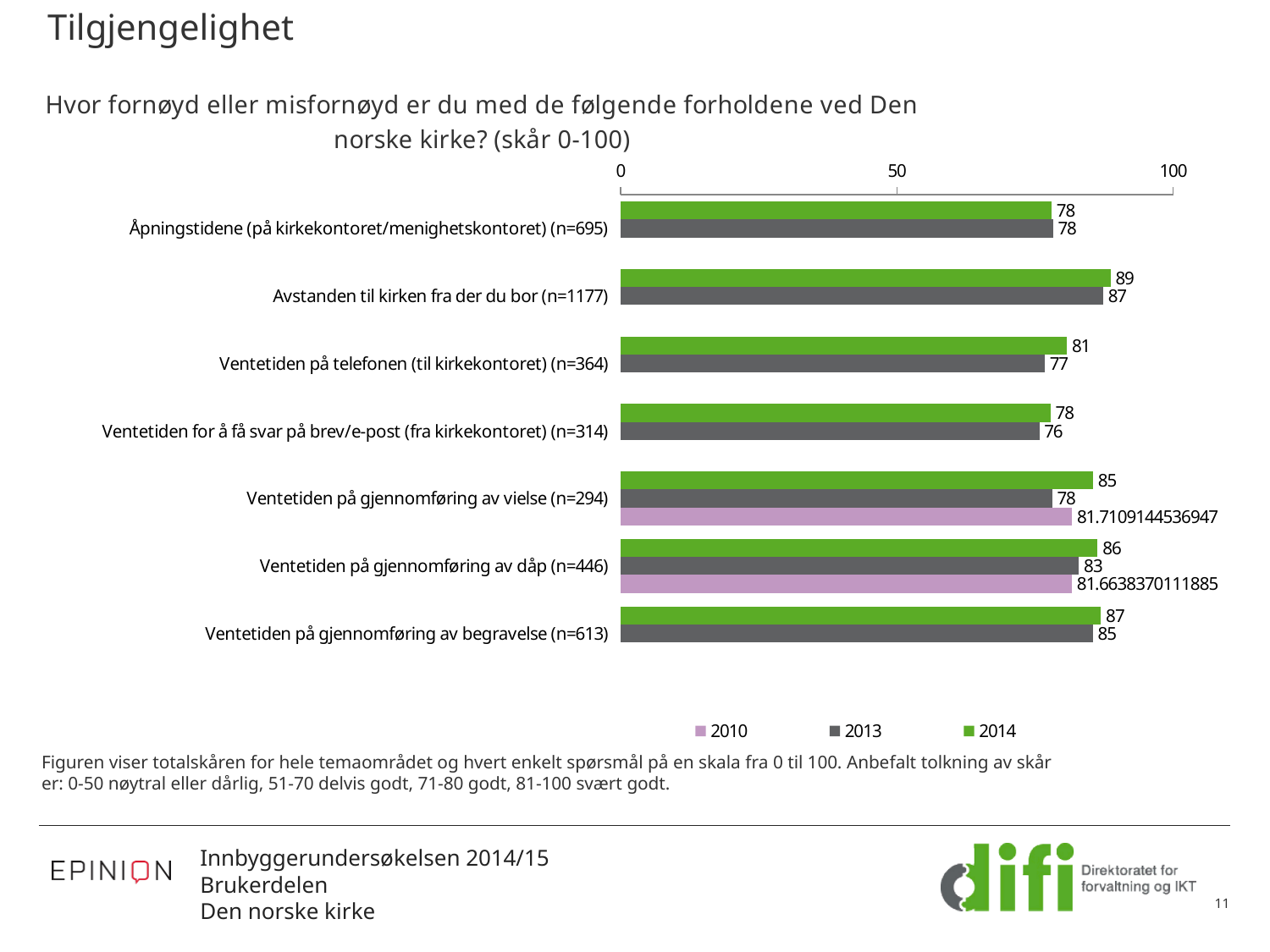
Which is larger for "Ventetiden på gjennomføring av dåp (n=446)": the 2014 value or the 2013 value? 2014 What is the 2014 value for "Avstanden til kirken fra der du bor (n=1177)"? 89 What kind of chart is shown on the slide? bar chart What is the difference between the 2014 and 2013 values for "Ventetiden på gjennomføring av vielse (n=294)"? 7 Is the 2014 value for "Ventetiden på gjennomføring av begravelse (n=613)" greater or less than 50? greater What is the 2010 value for "Ventetiden på gjennomføring av vielse (n=294)"? 81.7109144536947 Which category has the highest 2014 value? Avstanden til kirken fra der du bor (n=1177) What is the 2013 value for "Ventetiden på telefonen (til kirkekontoret) (n=364)"? 77 Which category has the lowest 2013 value? Ventetiden for å få svar på brev/e-post (fra kirkekontoret) (n=314) Which colour represents the 2014 series in the legend? green How many series does the legend list? 3 How many categories are shown on the chart? 7